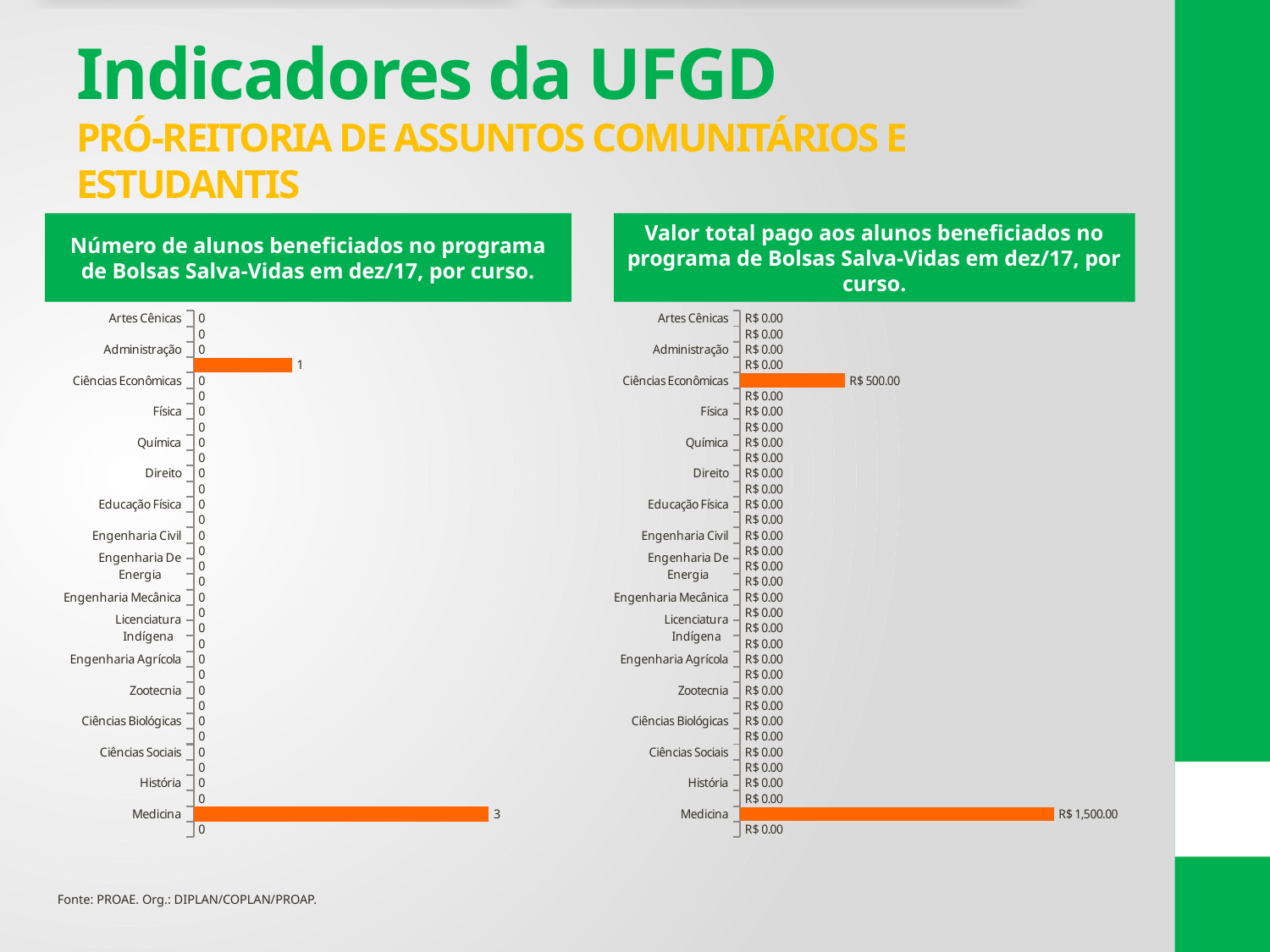
In the right chart (Valor total pago aos alunos beneficiados), what is the value for História? R$ 0.00 In the right chart (Valor total pago aos alunos beneficiados), what is the value for Medicina? R$ 1,500.00 What kind of chart is the left chart, 'Número de alunos beneficiados no programa de Bolsas Salva-Vidas em dez/17, por curso'? Bar chart In the left chart (Número de alunos beneficiados), what is the value for Artes Cênicas? 0 In the left chart (Número de alunos beneficiados), which course has the highest value? Medicina In the right chart (Valor total pago aos alunos beneficiados), what is the value for Ciências Econômicas? R$ 500.00 In the right chart (Valor total pago aos alunos beneficiados), what is the difference between the values for Medicina and Ciências Econômicas? R$ 1,000.00 What colour are the bars in the two charts on the slide? Orange In the right chart (Valor total pago aos alunos beneficiados), which is larger: the value for Medicina or the value for Ciências Econômicas? Medicina In the left chart (Número de alunos beneficiados), what is the value for Medicina? 3 In the left chart (Número de alunos beneficiados), what is the value for Física? 0 In the right chart (Valor total pago aos alunos beneficiados), which course has the highest value? Medicina